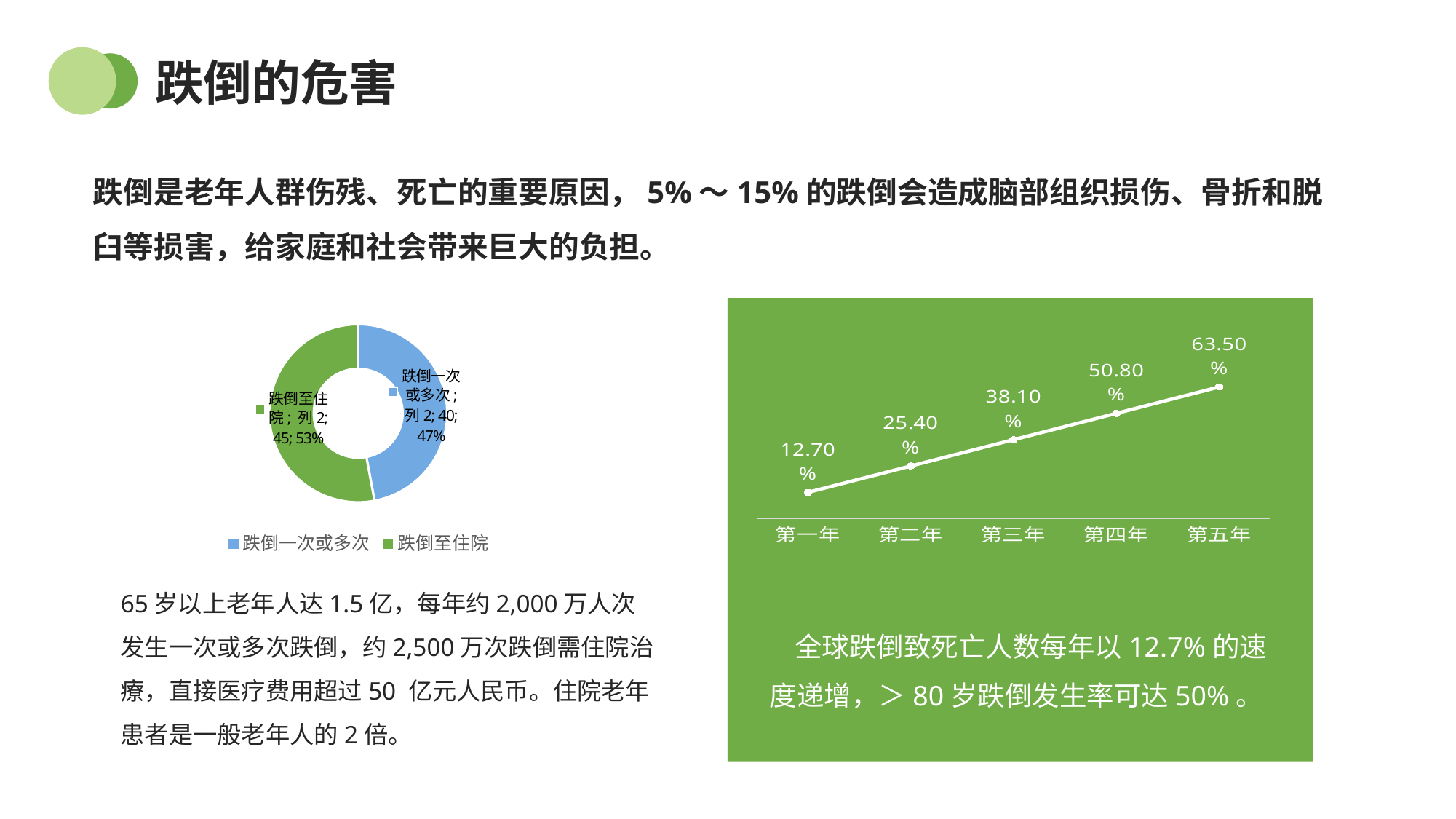
On the line chart on the right, do the values rise or fall from 第一年 to 第五年? rise How many data points are plotted on the line chart on the right? 5 On the line chart on the right, what is the value for 第五年? 63.50% On the doughnut chart on the left, what is the value for 跌倒一次或多次? 40 On the line chart on the right, which year has the highest value? 第五年 What kind of chart is shown on the right side of the slide? line chart On the line chart on the right, what is the value for 第三年? 38.10% On the doughnut chart on the left, which is larger, 跌倒一次或多次 or 跌倒至住院? 跌倒至住院 On the doughnut chart on the left, what share does 跌倒至住院 have? 53% How many entries does the legend of the doughnut chart on the left list? 2 On the line chart on the right, which year has the lowest value? 第一年 On the line chart on the right, what is the difference between the values for 第二年 and 第一年? 12.70%